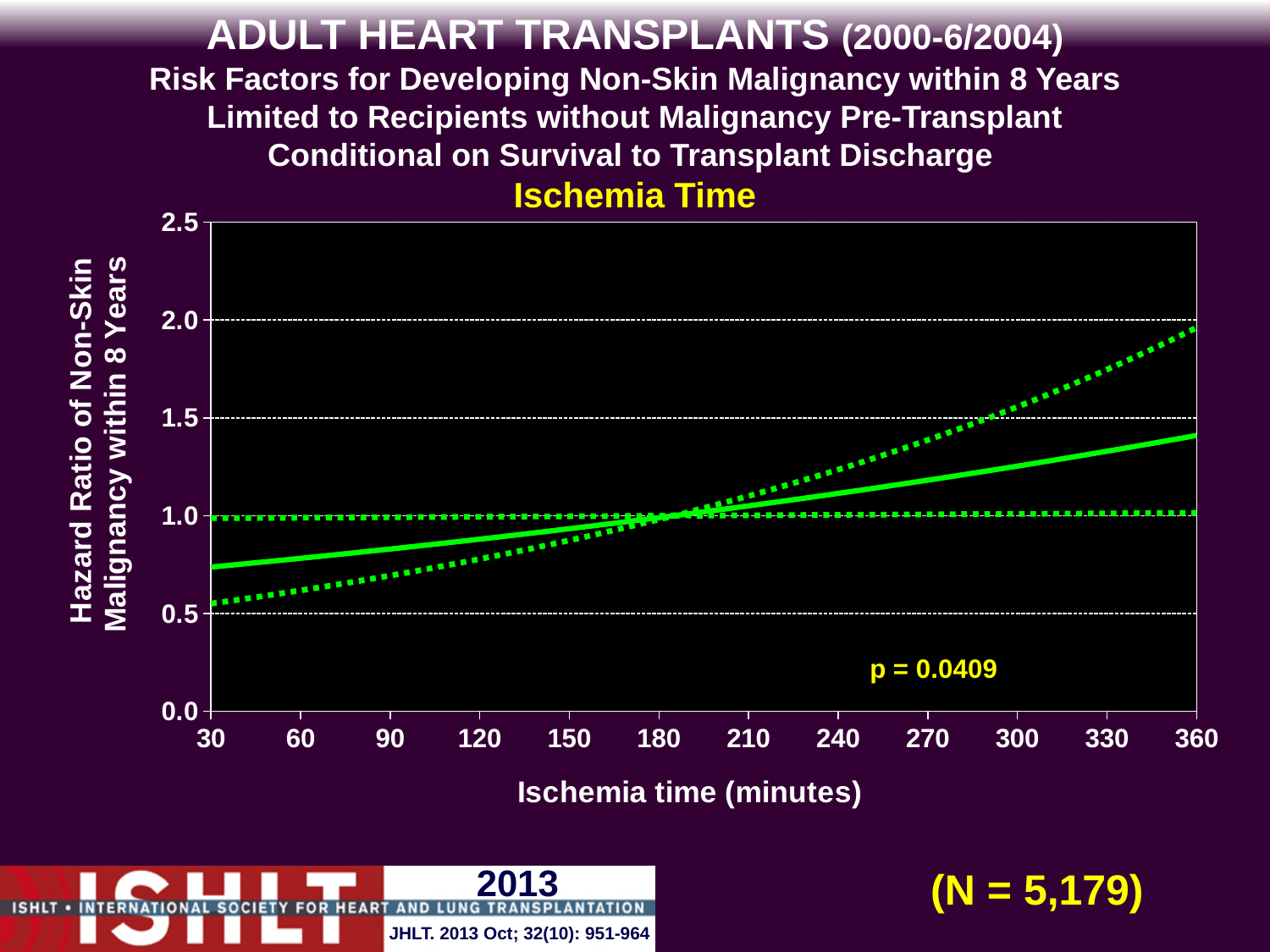
Is the value of the upper dotted line at 360 minutes greater or less than 1.5? greater Does the solid hazard ratio line rise or fall as ischemia time increases from 30 to 360 minutes? rise Is the value of the solid hazard ratio line at 360 minutes greater or less than 1.5? less How many tick labels are shown on the x axis? 12 How many lines are plotted on the chart? 3 What kind of chart is shown on the slide? line chart What p-value is printed on the chart? p = 0.0409 Is the value of the solid hazard ratio line at 30 minutes greater or less than 1.0? less What is the label of the x axis? Ischemia time (minutes)